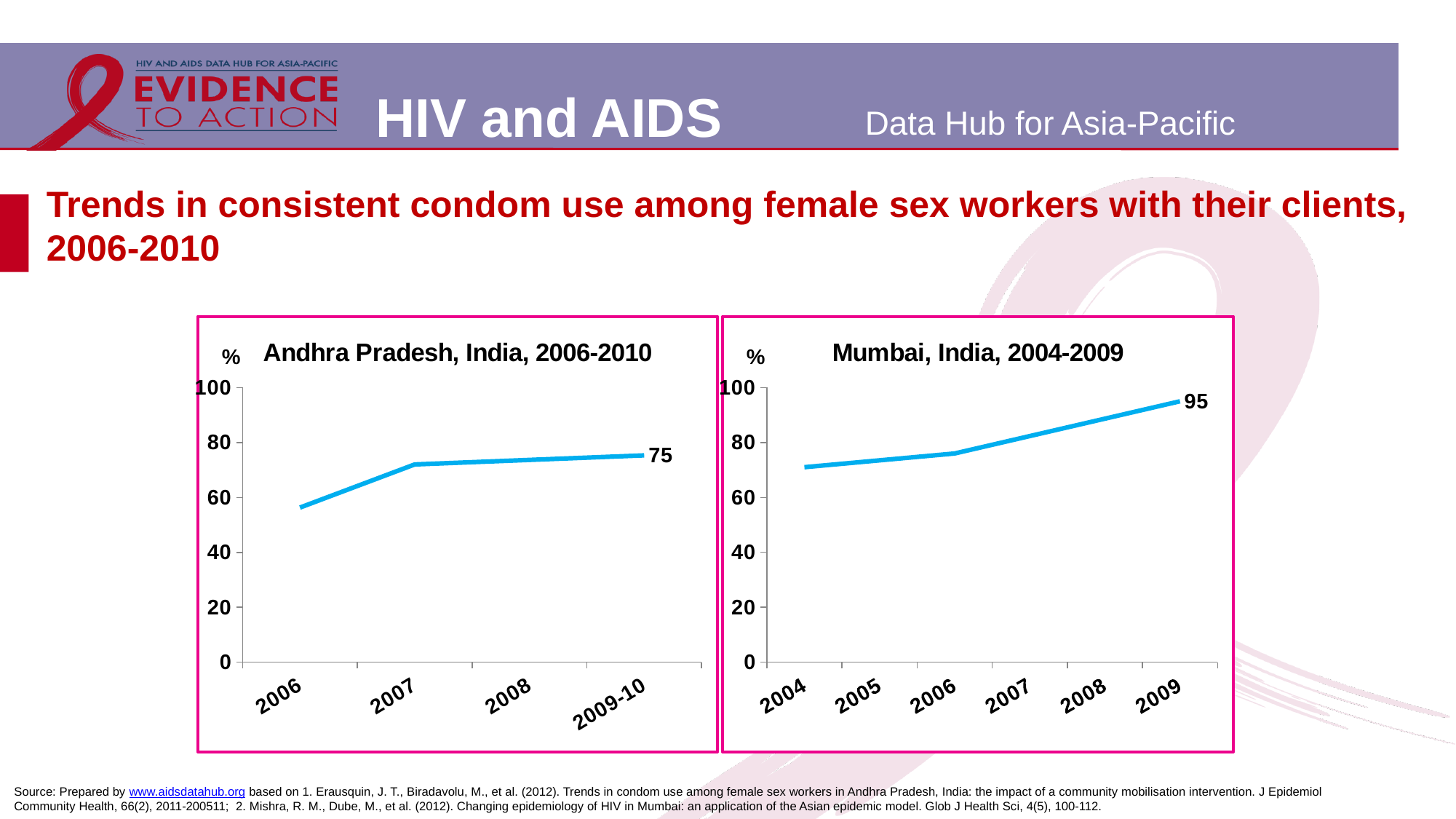
In the Mumbai, India, 2004-2009 chart, which year has the lowest value? 2004 What kind of chart is the Andhra Pradesh, India, 2006-2010 chart? Line chart In the Mumbai, India, 2004-2009 chart, do the values rise or fall from 2004 to 2009? Rise In the Mumbai, India, 2004-2009 chart, what is the value for 2009? 95 Which is larger: the 2009-10 value in the Andhra Pradesh chart or the 2009 value in the Mumbai chart? The 2009 value in the Mumbai chart (95) How many data points are plotted in the Andhra Pradesh, India, 2006-2010 chart? 3 In the Andhra Pradesh, India, 2006-2010 chart, which period has the highest value? 2009-10 In the Andhra Pradesh, India, 2006-2010 chart, what is the value for 2009-10? 75 How many data points are plotted in the Mumbai, India, 2004-2009 chart? 3 What is the title of the chart on the right side of the slide? Mumbai, India, 2004-2009 In the Andhra Pradesh, India, 2006-2010 chart, is the value for 2006 greater or less than 60? less